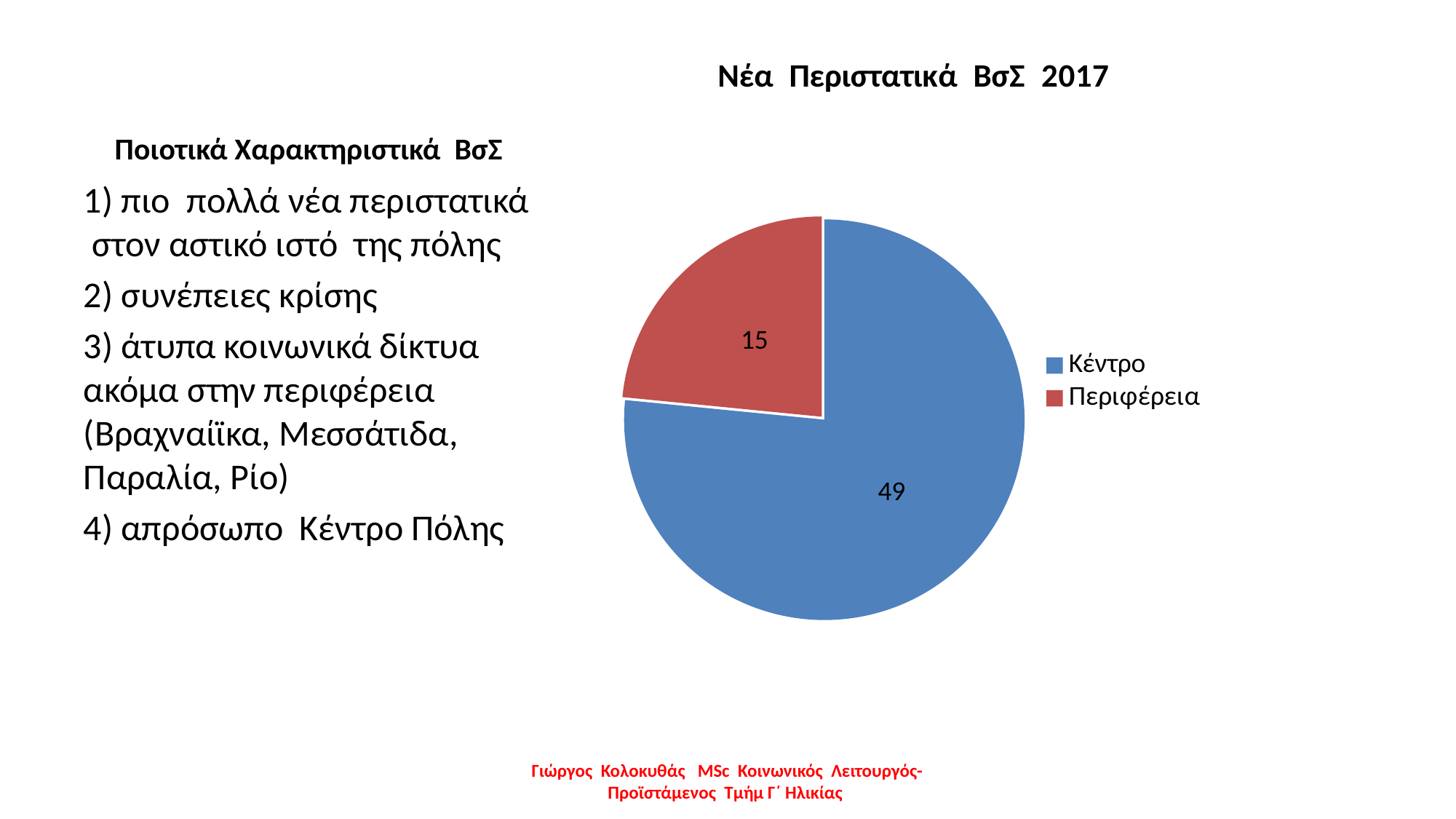
What is the value for Περιφέρεια in the pie chart? 15 What kind of chart is shown on the slide? Pie chart How many categories does the pie chart show? 2 What is the total of the two values shown in the pie chart? 64 Which is larger, the value for Κέντρο or the value for Περιφέρεια? Κέντρο What is the difference between the values for Κέντρο and Περιφέρεια? 34 Which colour represents Περιφέρεια in the pie chart? Red What is the value for Κέντρο in the pie chart? 49 What is the title of the chart? Νέα Περιστατικά ΒσΣ 2017 Which category has the largest slice in the pie chart? Κέντρο Which category has the smallest slice in the pie chart? Περιφέρεια